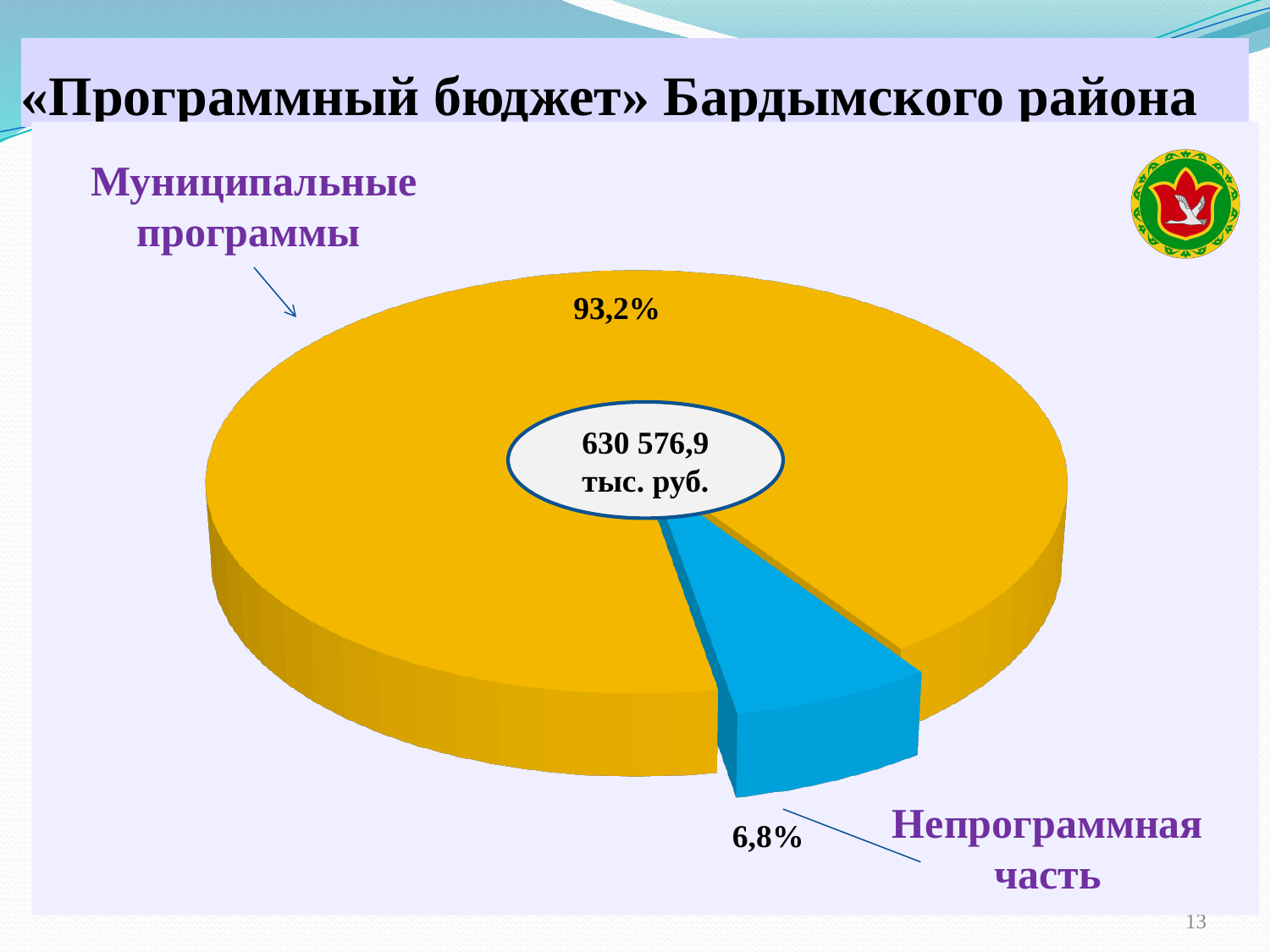
What colour is the "Непрограммная часть" slice of the pie chart? Blue What share of the pie chart is labelled "Муниципальные программы"? 93,2% What share of the pie chart is labelled "Непрограммная часть"? 6,8% Which is larger: the "Муниципальные программы" slice or the "Непрограммная часть" slice? Муниципальные программы What kind of chart is shown on the slide? Pie chart How many slices does the pie chart have? 2 Which slice of the pie chart is the largest? Муниципальные программы What total amount is shown in the centre of the pie chart? 630 576,9 тыс. руб. Which slice of the pie chart is the smallest? Непрограммная часть What colour is the "Муниципальные программы" slice of the pie chart? Yellow What is the difference in percentage points between the "Муниципальные программы" slice and the "Непрограммная часть" slice? 86,4 Is the share of "Непрограммная часть" greater or less than 10%? less